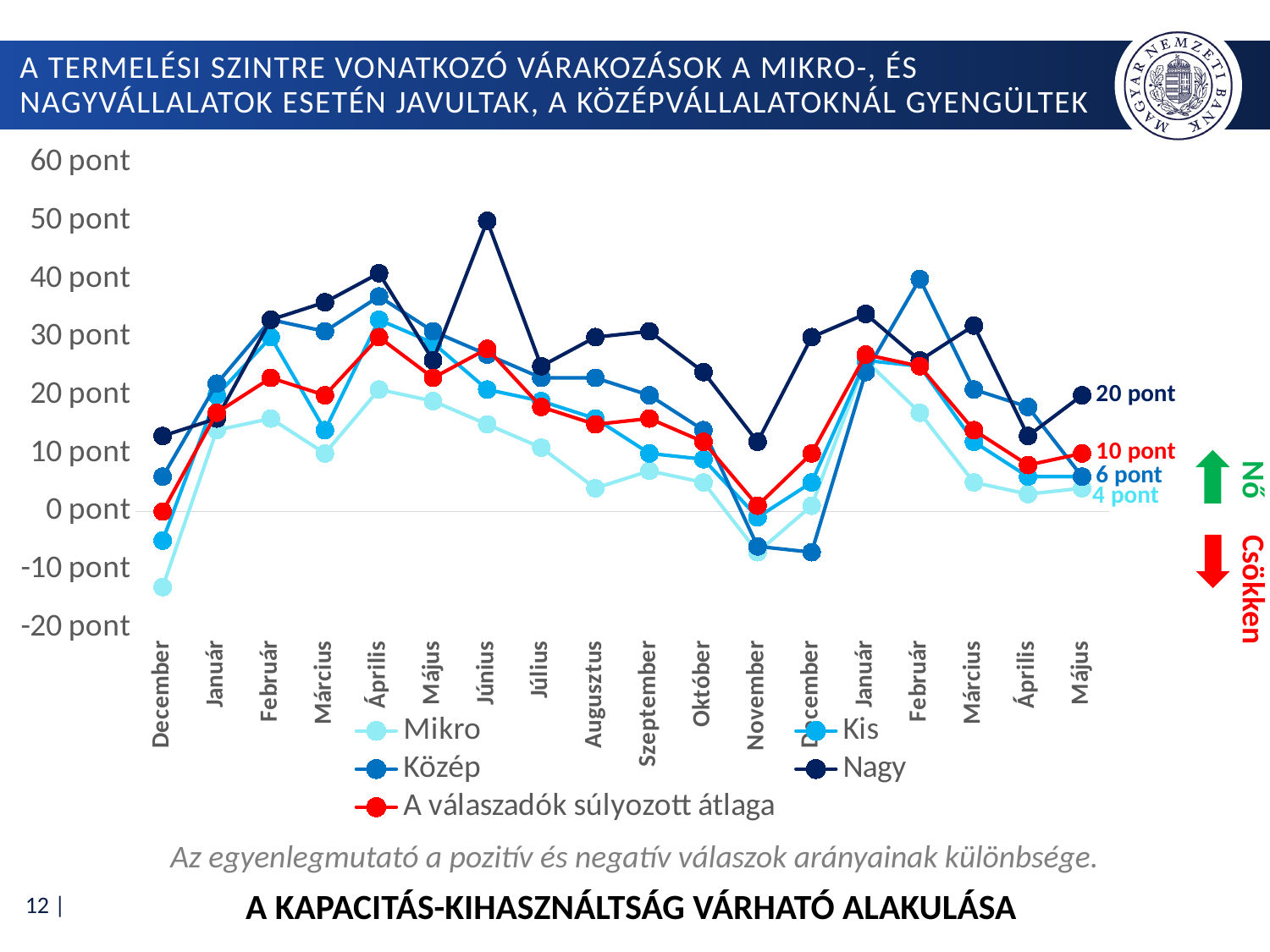
In the second Február, which series has the larger value, Közép or Nagy? Közép Is the value of the Nagy series in Június greater or less than 40 pont? greater What is the difference between the Nagy and Mikro values at the final Május point? 16 pont Which series has the lowest value in the first December? Mikro Which series has the highest value in Június? Nagy Is the value of the Mikro series in the first December greater or less than -10 pont? less What is the value of the Nagy series at the final Május point? 20 pont How many series does the legend list? 5 What is the value of 'A válaszadók súlyozott átlaga' at the final Május point? 10 pont What is the value of the Mikro series at the final Május point? 4 pont What kind of chart is shown on the slide? line chart How many months are shown along the x axis? 18